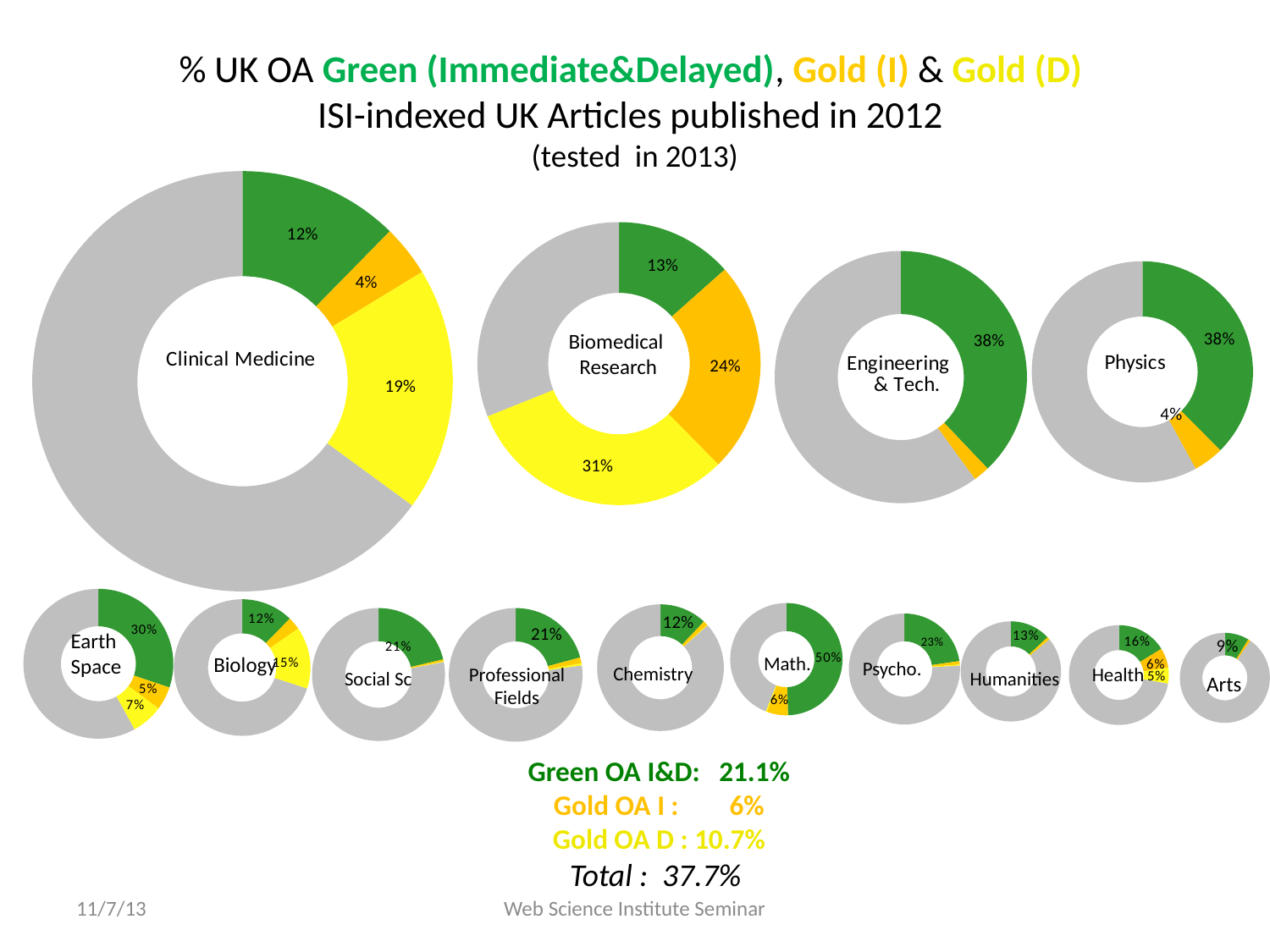
Which is larger: the green slice in the Biomedical Research chart or the green slice in the Engineering & Tech. chart? Engineering & Tech. In the Math. chart, what percentage is shown for the green (Green OA) slice? 50% According to the summary text at the bottom of the slide, what is the overall Green OA I&D percentage? 21.1% In the Biomedical Research chart, what percentage is shown for the orange (Gold I) slice? 24% In the Earth Space chart, what percentage is shown for the green (Green OA) slice? 30% In the Clinical Medicine chart, what is the combined percentage of the three labelled OA slices (green, orange and yellow)? 35% In the Physics chart, what percentage is shown for the green (Green OA) slice? 38% What kind of chart is used for each discipline on this slide? Donut (pie) chart In the Clinical Medicine chart, what percentage is shown for the yellow (Gold D) slice? 19% What is the difference between the yellow (Gold D) slice in the Biomedical Research chart and the yellow (Gold D) slice in the Clinical Medicine chart? 12% In the Clinical Medicine chart, what percentage is shown for the green (Green OA) slice? 12% In the Biomedical Research chart, what percentage is shown for the yellow (Gold D) slice? 31%